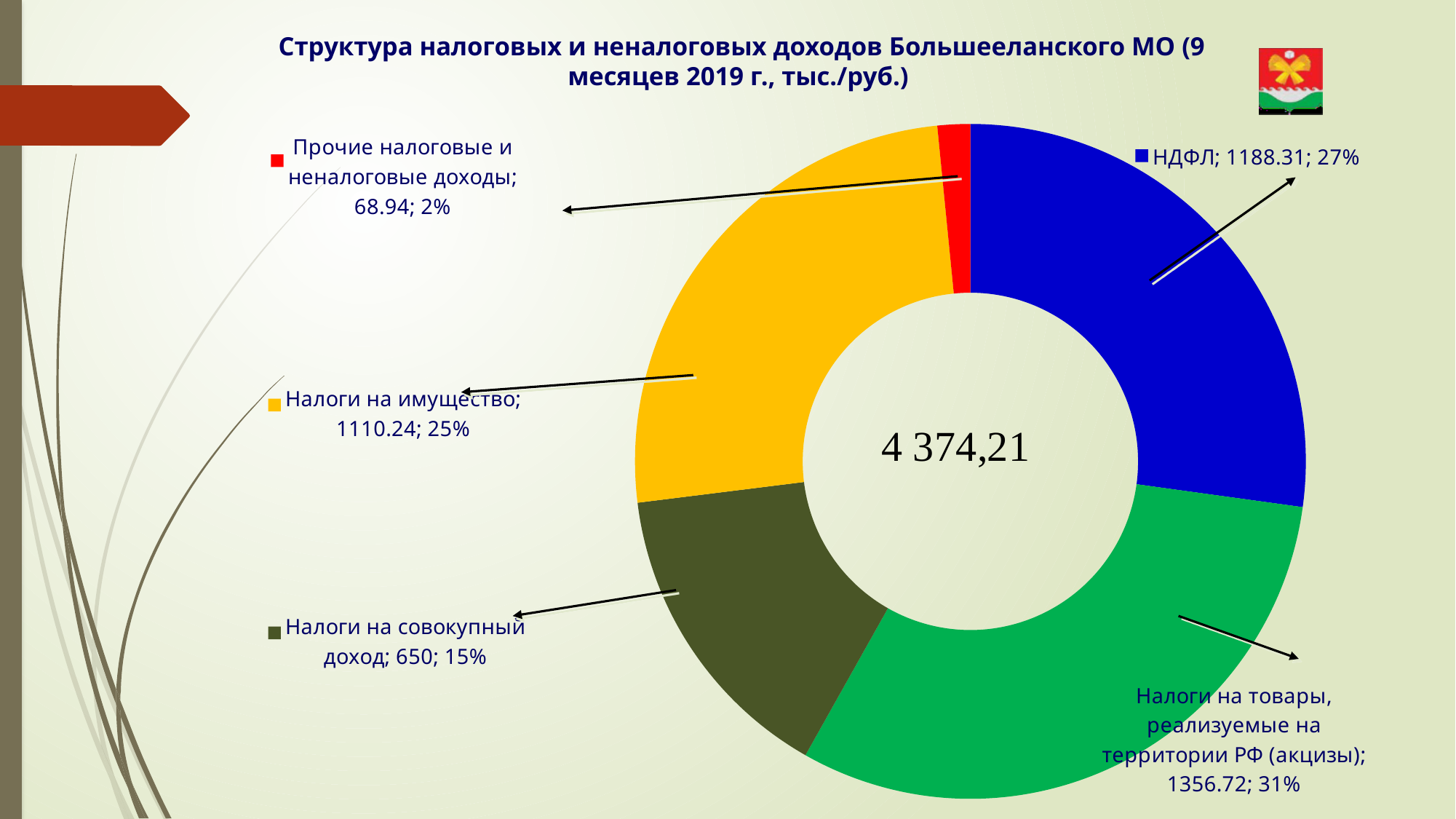
What is the value for Налоги на совокупный доход? 650 What total value is printed in the centre of the doughnut chart? 4 374,21 What is the value for Налоги на имущество? 1110.24 What is the difference between the values for НДФЛ and Налоги на имущество? 78.07 Which is larger: the value for НДФЛ or the value for Налоги на совокупный доход? НДФЛ Which category has the highest value? Налоги на товары, реализуемые на территории РФ (акцизы) What type of chart is shown on the slide? Doughnut (pie) chart What is the value for НДФЛ? 1188.31 What share of the chart does Налоги на товары, реализуемые на территории РФ (акцизы) represent? 31% Which category has the lowest value? Прочие налоговые и неналоговые доходы What share of the chart does Прочие налоговые и неналоговые доходы represent? 2% How many categories are shown in the chart? 5